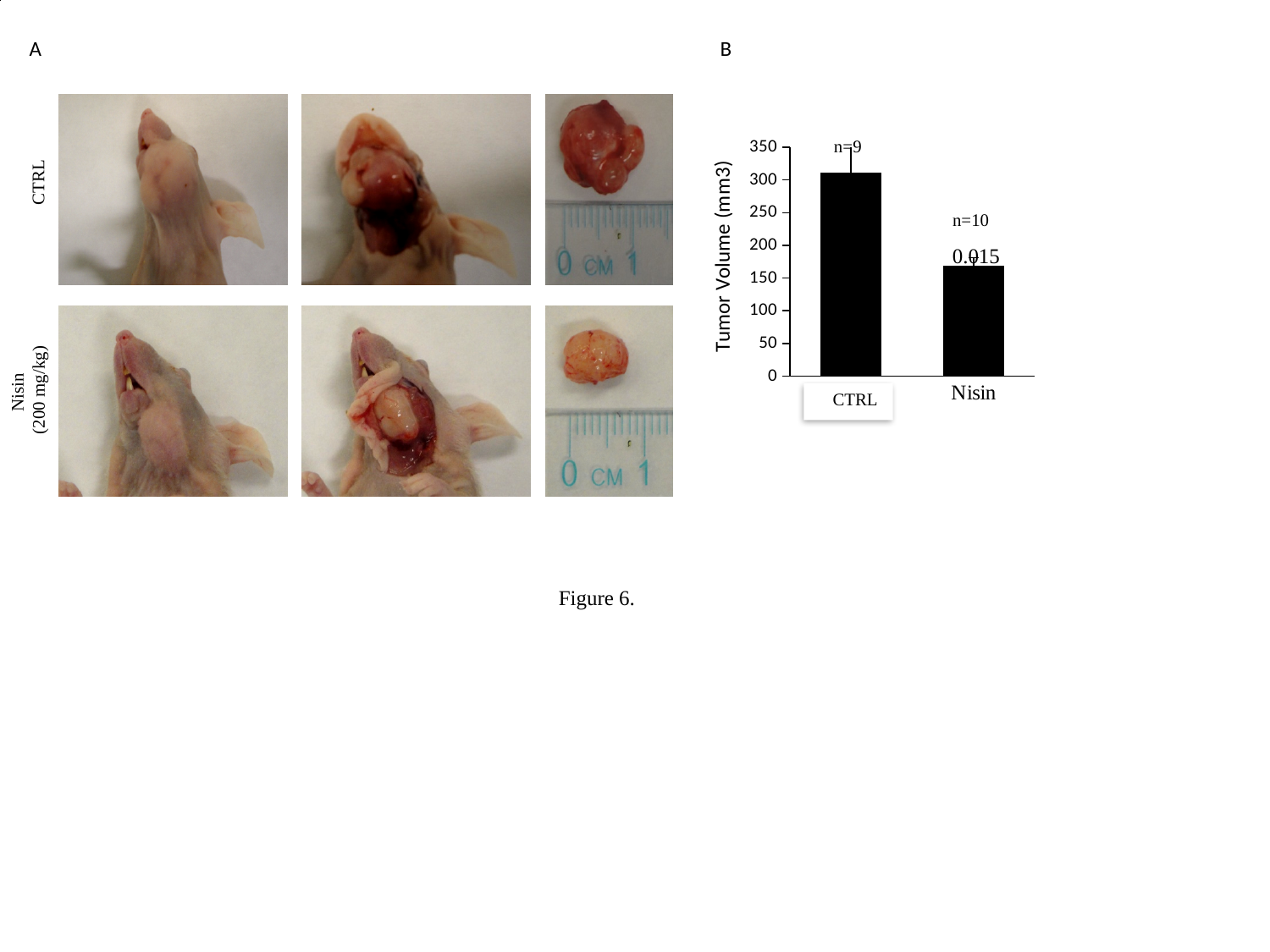
In the chart in panel B, is the tumor volume for Nisin greater or less than 150? greater In the chart in panel B, what sample size is annotated above the CTRL bar? n=9 In the chart in panel B, which group has the lower tumor volume? Nisin In the chart in panel B, is the tumor volume for CTRL greater or less than 250? greater What kind of chart is shown in panel B? bar chart In the chart in panel B, is the tumor volume for Nisin greater or less than 200? less In the chart in panel B, is the tumor volume for CTRL larger or smaller than for Nisin? larger What is the y-axis label of the chart in panel B? Tumor Volume (mm3) In the chart in panel B, what is the maximum value shown on the y axis? 350 In the chart in panel B, which group has the higher tumor volume? CTRL How many bars are plotted in the chart in panel B? 2